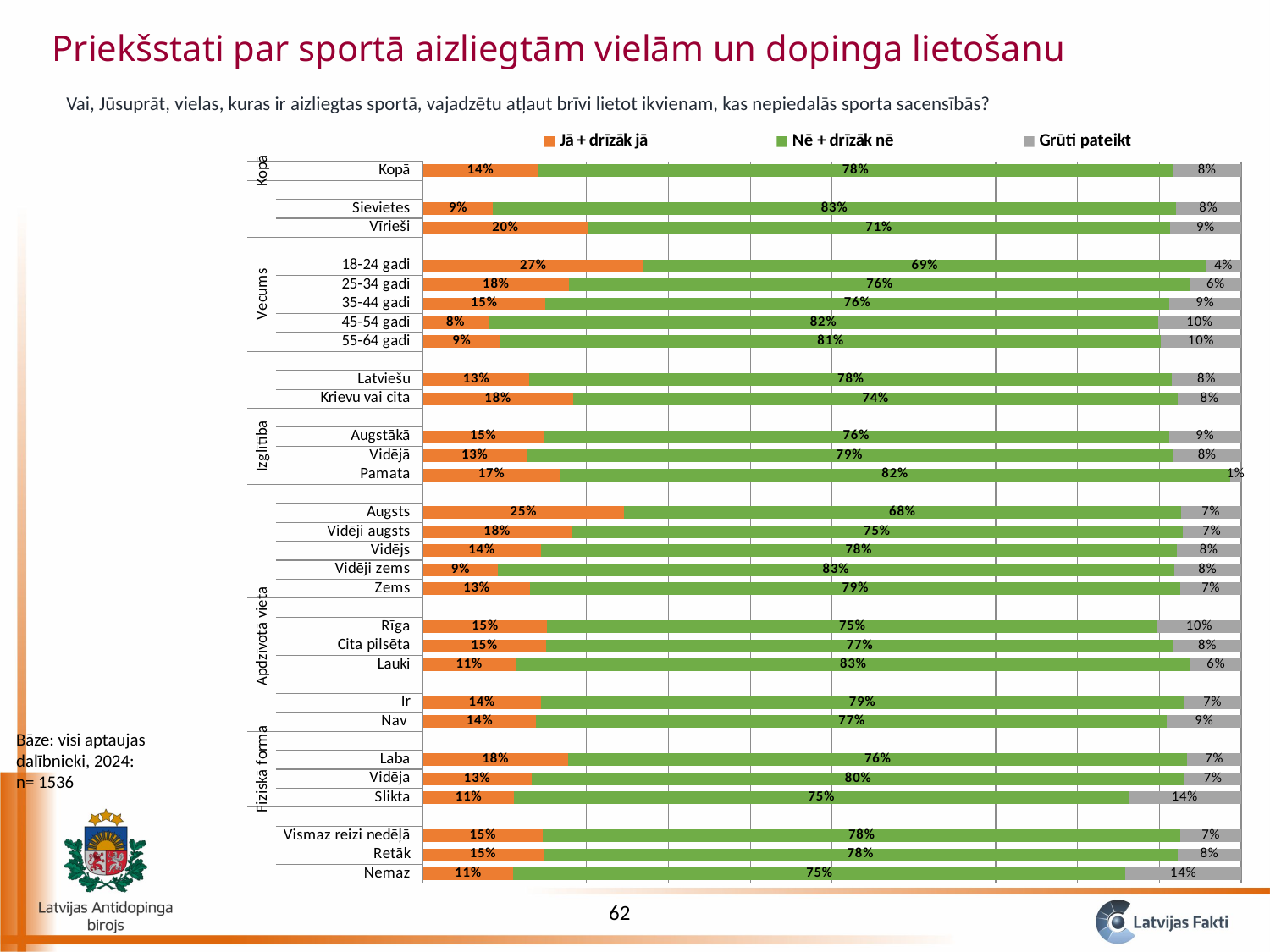
Which category has the lowest value for "Grūti pateikt"? Pamata What kind of chart is shown on the slide? Stacked bar chart Which has a larger "Nē + drīzāk nē" value, Rīga or Lauki? Lauki What is the value of "Nē + drīzāk nē" for the Pamata category? 82% How many series does the legend list? 3 What is the value of "Grūti pateikt" for the Slikta category? 14% What colour represents the "Nē + drīzāk nē" series in the legend? Green What is the value of "Nē + drīzāk nē" for the 18-24 gadi category? 69% What is the difference in percentage points between the "Jā + drīzāk jā" values for Vīrieši and Sievietes? 11 Which category has the highest value for "Jā + drīzāk jā"? 18-24 gadi What is the value of "Jā + drīzāk jā" for the Kopā category? 14% Which category has the lowest value for "Jā + drīzāk jā"? 45-54 gadi